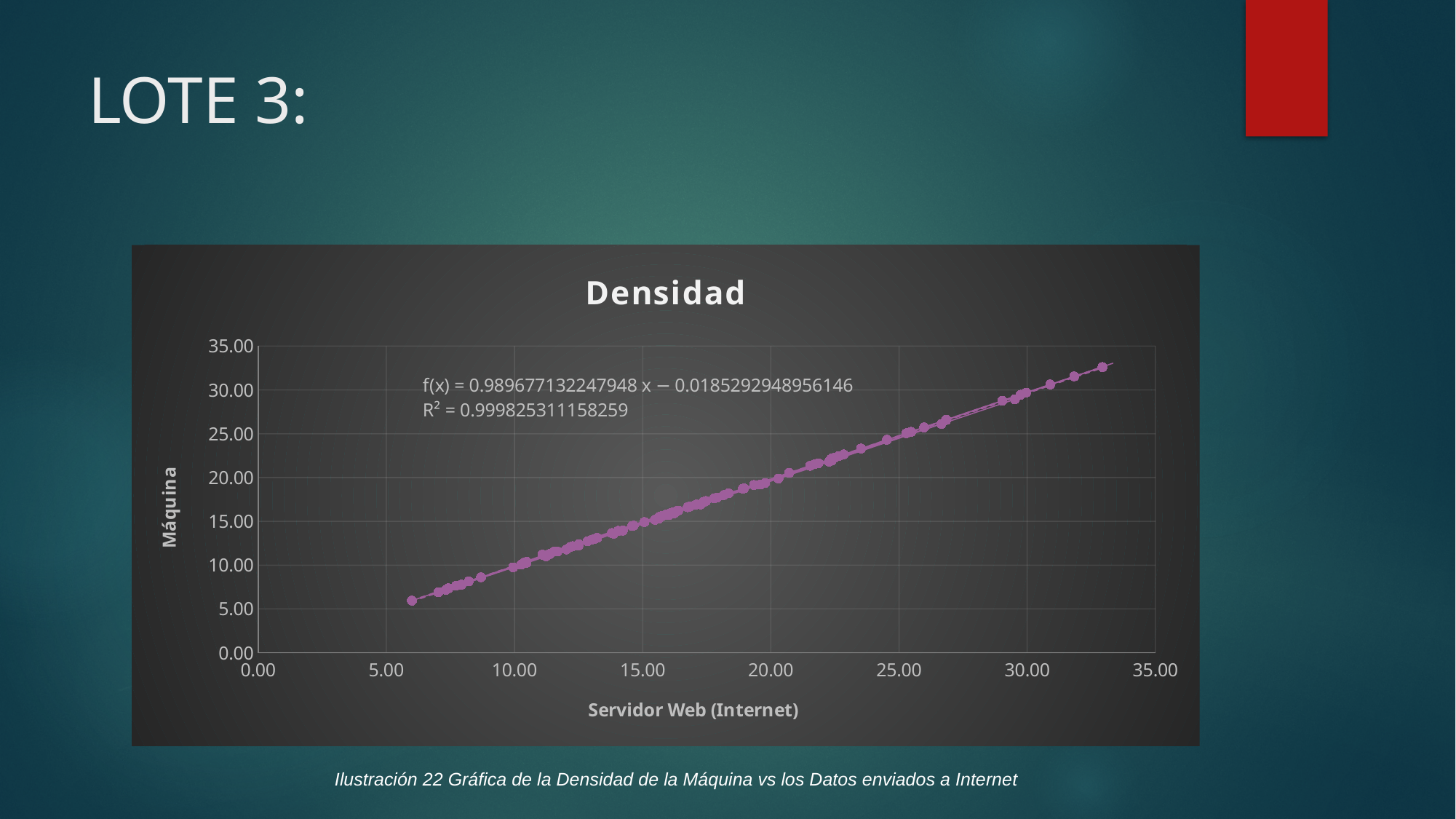
What kind of chart is shown on the slide? Scatter chart Is the Máquina value for the point at Servidor Web (Internet) 20.00 greater or less than 15.00? greater Is the Máquina value for the point at Servidor Web (Internet) 30.00 greater or less than 25.00? greater Do the Máquina values rise or fall as Servidor Web (Internet) increases? Rise What is the title of the chart? Densidad What is the highest value shown on the y axis of the chart? 35.00 Is the Máquina value of the leftmost point greater or less than 10.00? less What is the intercept of the trendline equation printed on the chart? −0.0185292948956146 What is the label of the x axis of the chart? Servidor Web (Internet) What is the slope of the trendline equation printed on the chart? 0.989677132247948 What R² value is printed on the chart? R² = 0.999825311158259